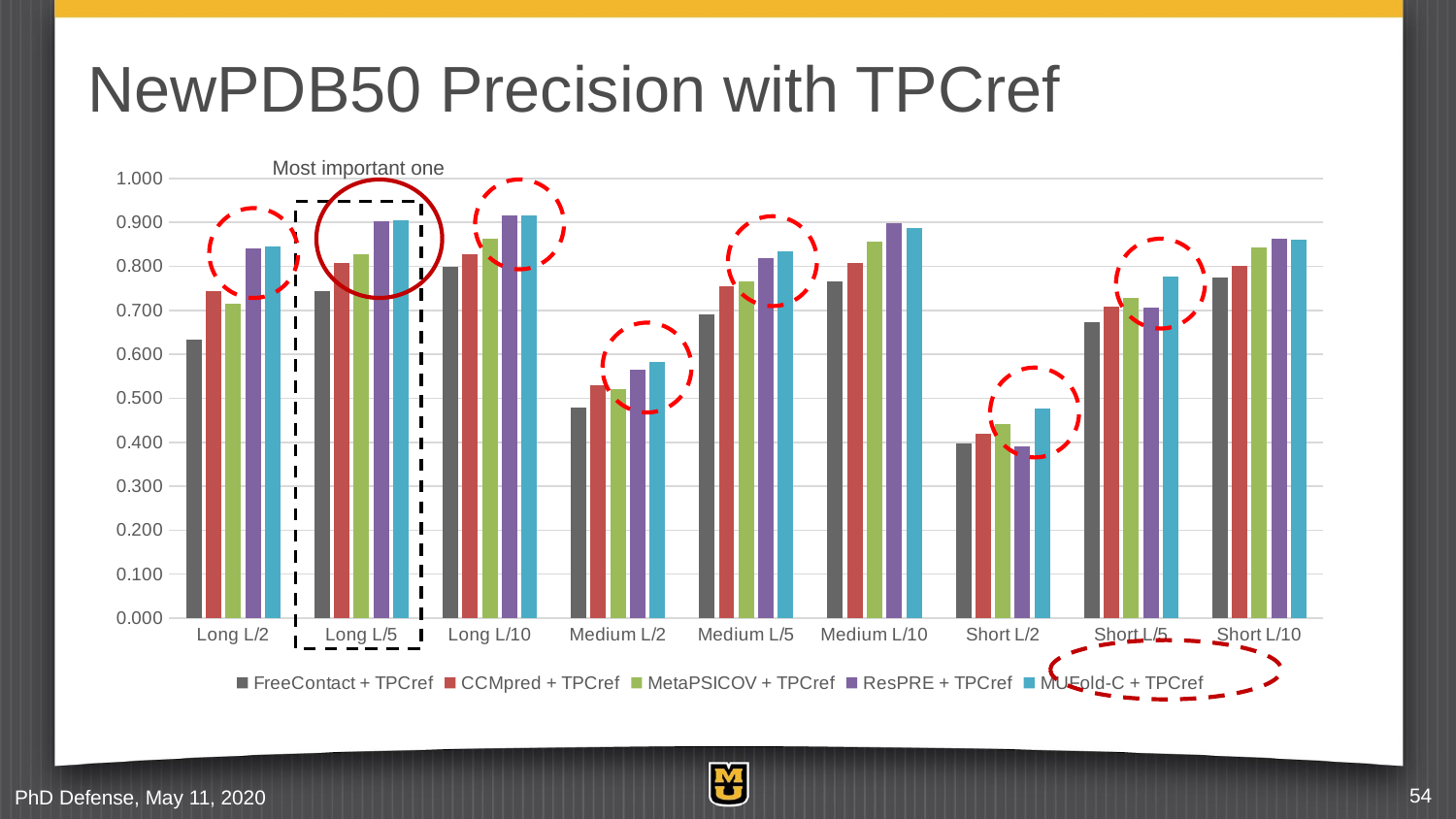
Which series has the lowest value in the Long L/2 category? FreeContact + TPCref Which series has the highest value in the Short L/5 category? MUFold-C + TPCref How many series does the chart legend list? 5 Which category is marked with a dashed box and labelled 'Most important one'? Long L/5 Which series has the highest value in the Short L/2 category? MUFold-C + TPCref How many categories are shown along the x axis of the chart? 9 What is the title of the chart on the slide? NewPDB50 Precision with TPCref For FreeContact + TPCref, do the values rise or fall going from Long L/2 to Long L/5 to Long L/10? rise What type of chart is shown on the slide? bar chart Is the value for FreeContact + TPCref in the Medium L/2 category greater or less than 0.500? less In the Long L/5 category, which is larger: FreeContact + TPCref or CCMpred + TPCref? CCMpred + TPCref Is the value for MUFold-C + TPCref in the Short L/10 category greater or less than 0.800? greater